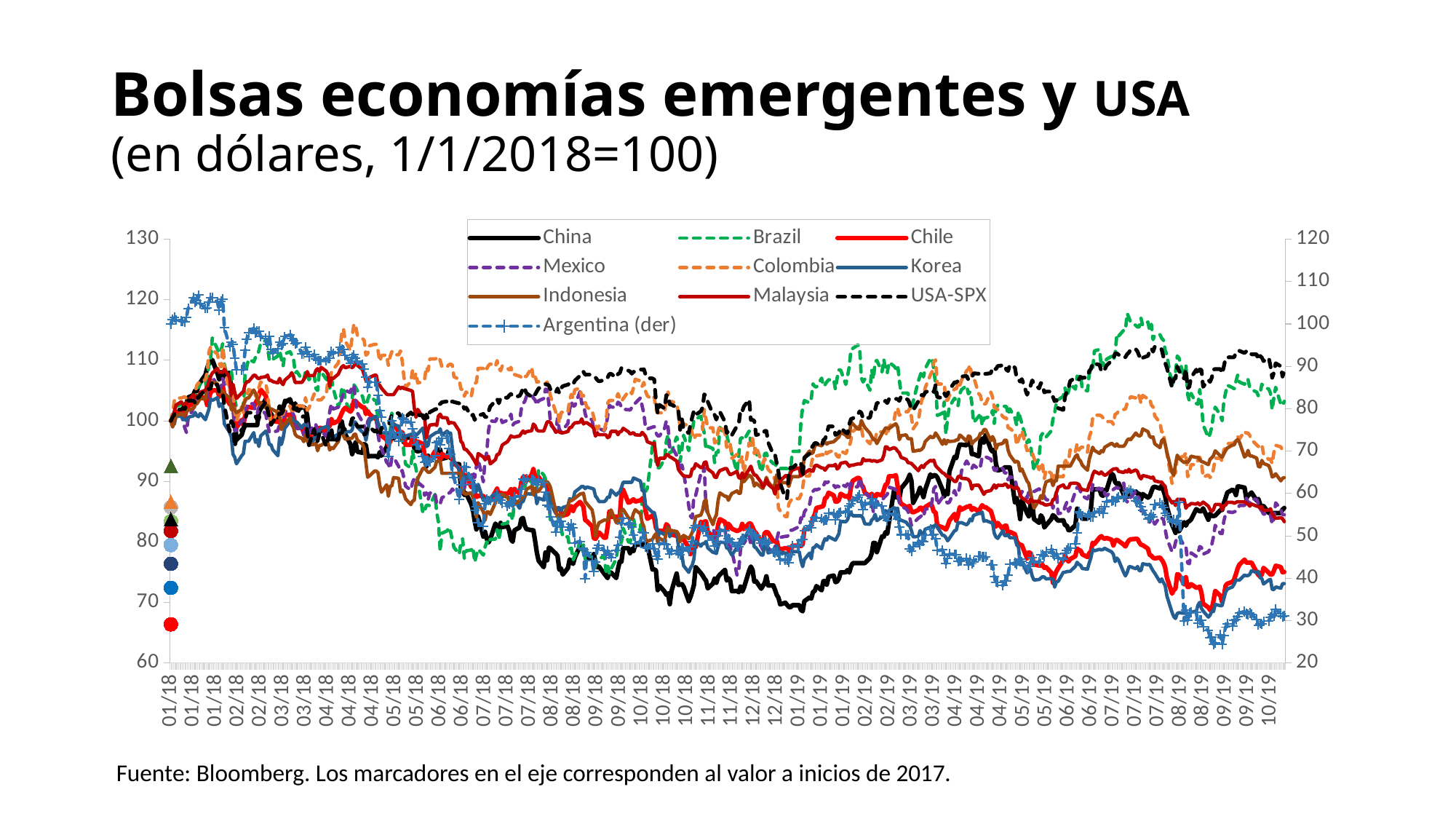
Is the value for Chile at the end of the period (10/19) greater or less than 50? greater Is the value for Argentina (der) at the end of the period (10/19), read on the right axis, greater or less than 40? less Among the series plotted on the left axis, which has the lowest value at the end of the period (10/19)? Korea Does the USA-SPX series rise or fall overall from 01/18 to 10/19? rise Does the Chile series rise or fall overall from 01/18 to 10/19? fall Which series has the highest value at the end of the period (10/19)? USA-SPX Which series is plotted against the right-hand axis? Argentina (der) Is the value for USA-SPX at the end of the period (10/19) greater or less than 100? greater What kind of chart is shown on the slide? line chart What is the title of the chart? Bolsas economías emergentes y USA (en dólares, 1/1/2018=100) How many series does the legend list? 10 At the end of the period (10/19), which is higher: Indonesia or Chile? Indonesia